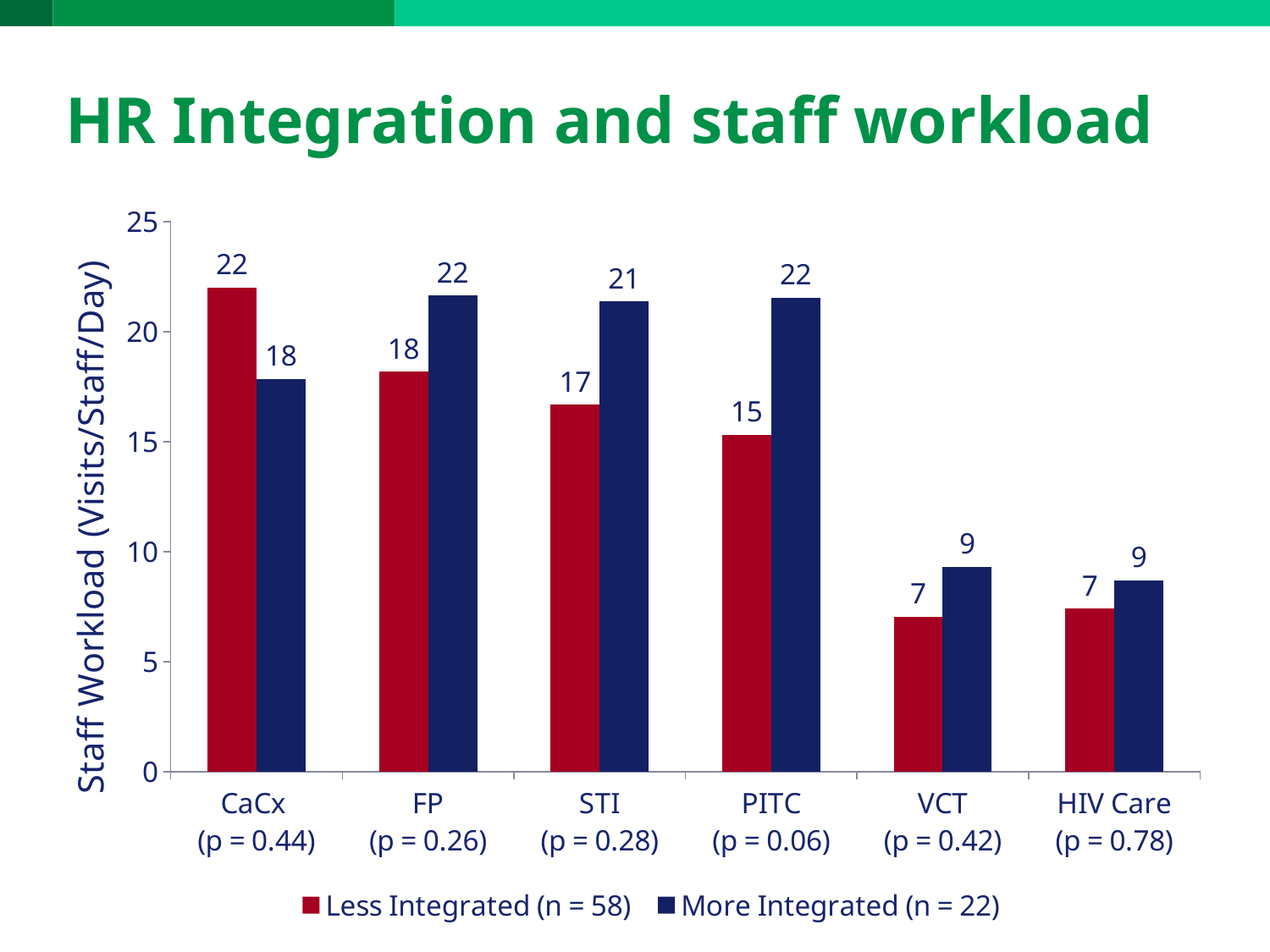
What is the staff workload for the More Integrated group at STI? 21 What kind of chart is shown on the slide? bar chart What is the difference between the More Integrated and Less Integrated staff workload at PITC? 7 What is the staff workload for the More Integrated group at VCT? 9 Is the Less Integrated staff workload at PITC greater or less than 20? less How many service categories are shown on the x axis? 6 How many series does the legend list? 2 What is the difference between the Less Integrated and More Integrated staff workload at CaCx? 4 At FP, which group has the larger staff workload, Less Integrated or More Integrated? More Integrated Which service has the highest staff workload for the Less Integrated group? CaCx What is the staff workload for the Less Integrated group at CaCx? 22 What is the staff workload for the Less Integrated group at PITC? 15